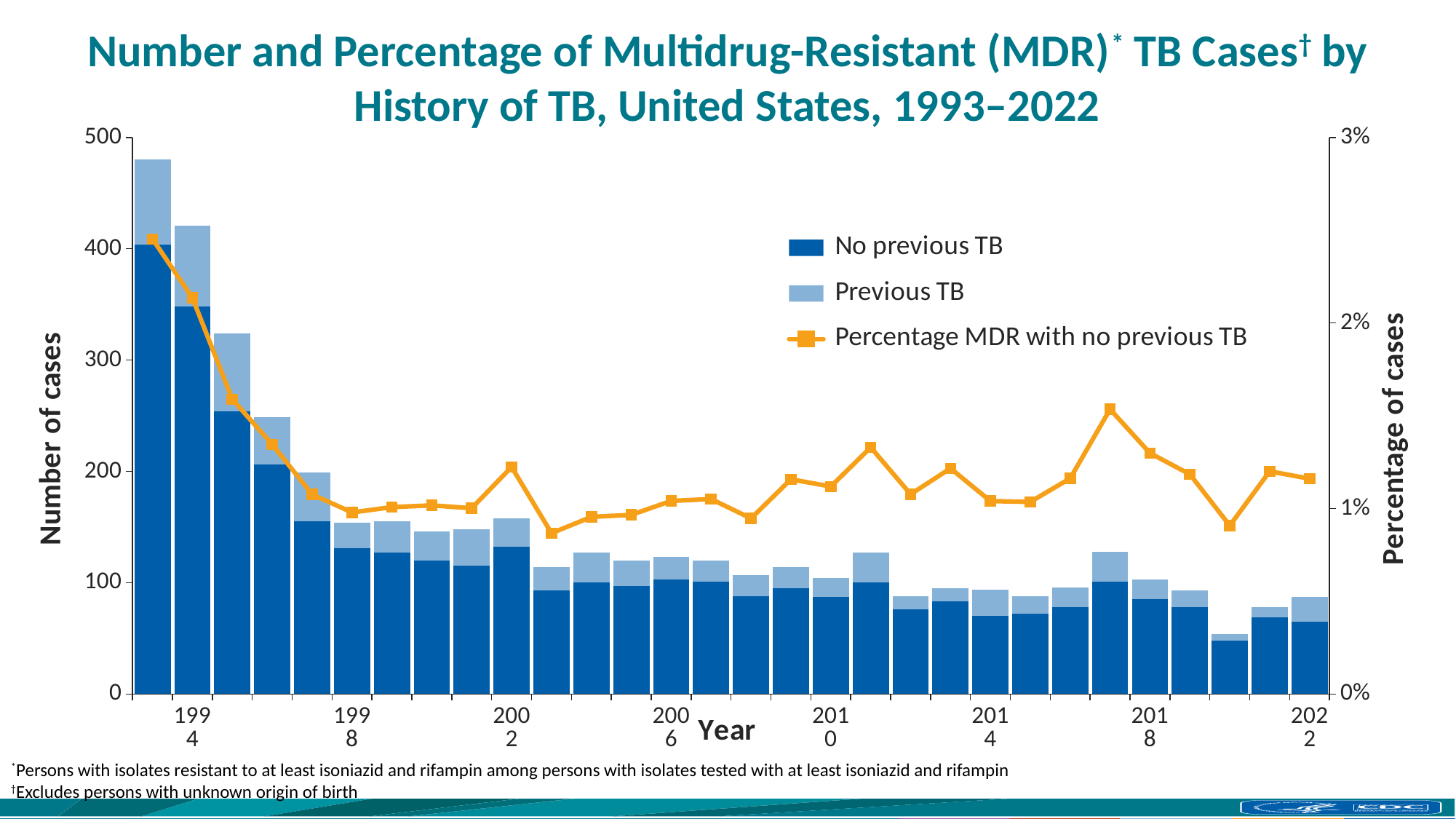
How many years (bars) are plotted on the chart? 30 Is the total number of cases in 2022 greater or less than 100? less Overall, do the total numbers of MDR TB cases rise or fall from 1993 to 2022? fall In which year is the percentage of MDR with no previous TB highest? 1993 How many series does the legend list? 3 Is the percentage of MDR with no previous TB in 2017 greater or less than 1%? greater Which series is plotted as the orange line with square markers? Percentage MDR with no previous TB Is the total number of cases in 1993 greater or less than 400? greater Which year has the highest total number of MDR TB cases? 1993 Which year has the lowest total number of MDR TB cases? 2020 What kind of chart is shown on the slide? A stacked bar chart combined with a line chart